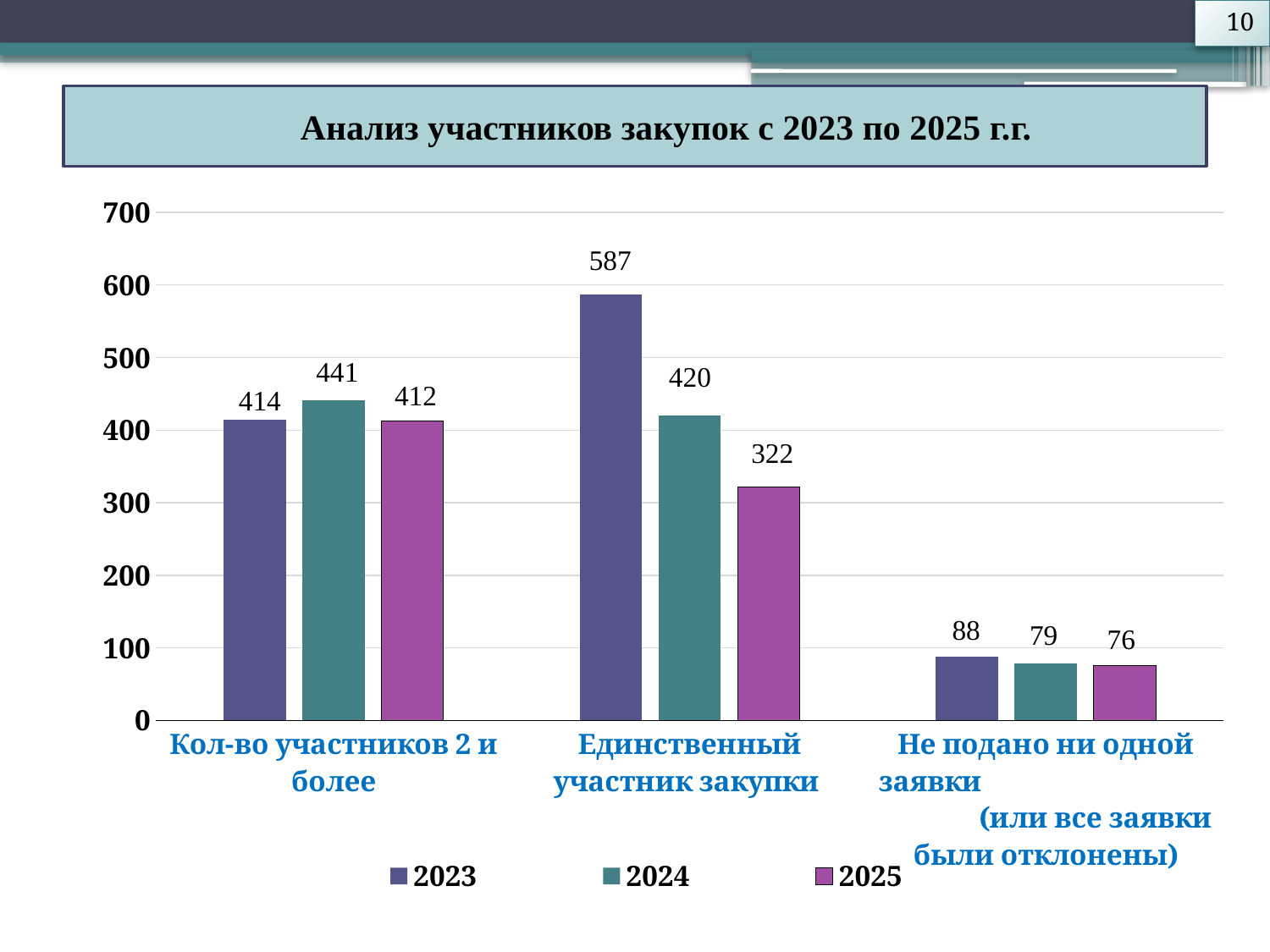
Is the 2025 value for "Единственный участник закупки" greater or less than 400? less What is the value for 2025 in the category "Не подано ни одной заявки (или все заявки были отклонены)"? 76 Which year has the highest value in the category "Единственный участник закупки"? 2023 What is the title of the chart? Анализ участников закупок с 2023 по 2025 г.г. What is the value for 2023 in the category "Единственный участник закупки"? 587 What is the value for 2024 in the category "Кол-во участников 2 и более"? 441 How many categories are shown on the x axis? 3 What kind of chart is shown on the slide? bar chart Which category has the lowest value for 2024? Не подано ни одной заявки (или все заявки были отклонены) How many series does the legend list? 3 Which is larger: the 2024 value or the 2025 value for "Кол-во участников 2 и более"? 2024 What is the difference between the 2023 and 2025 values in the category "Единственный участник закупки"? 265